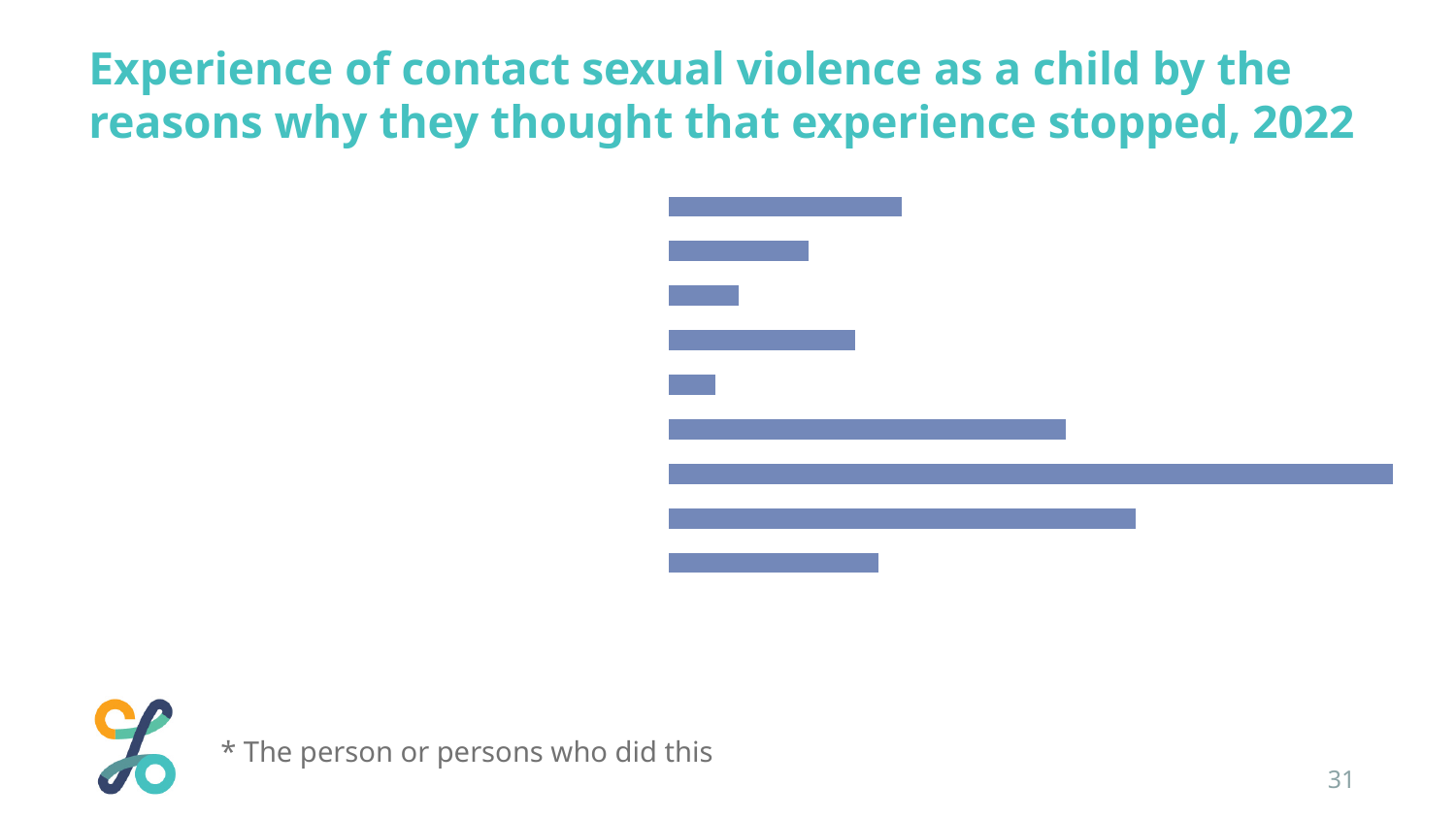
Are the bars in the chart oriented horizontally or vertically? horizontally Is the third bar from the top longer or shorter than the ninth bar from the top? shorter Is the eighth bar from the top longer or shorter than the sixth bar from the top? longer Counting from the top, which bar is the longest in the chart? the seventh bar What is the title of the chart on the slide? Experience of contact sexual violence as a child by the reasons why they thought that experience stopped, 2022 Which year does the chart title refer to? 2022 What kind of chart is shown on the slide? bar chart How many bars does the chart contain? 9 Counting from the top, which bar is the shortest in the chart? the fifth bar Is the first bar from the top longer or shorter than the second bar from the top? longer